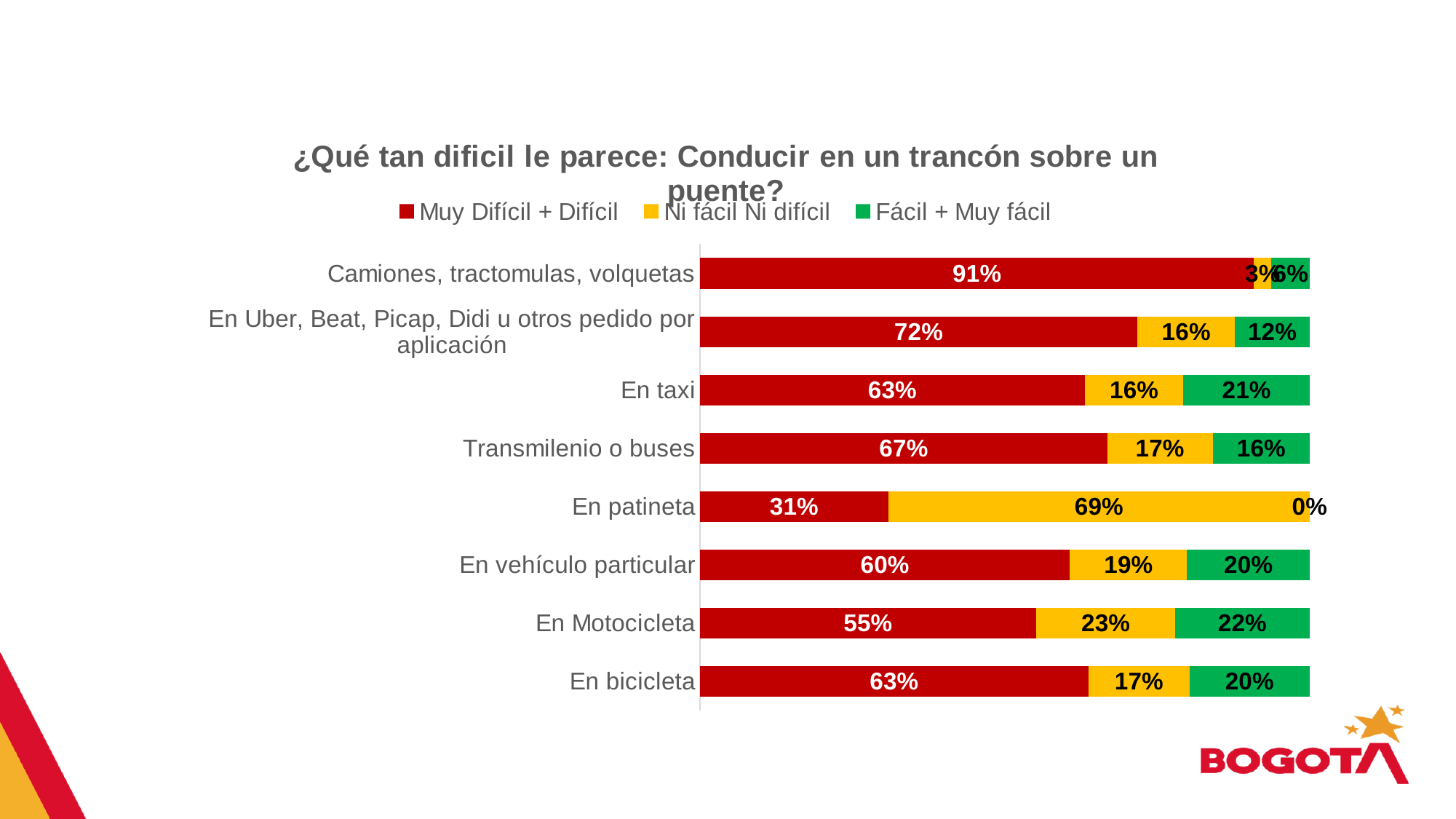
What is the difference between the 'Muy Difícil + Difícil' values for 'En Uber, Beat, Picap, Didi u otros pedido por aplicación' and 'En Motocicleta'? 17% How many categories are shown in the chart? 8 Which has a larger 'Fácil + Muy fácil' value: 'En Motocicleta' or 'Transmilenio o buses'? En Motocicleta What is the 'Ni fácil Ni difícil' value for 'En patineta'? 69% What percentage of respondents rated driving in a traffic jam on a bridge as 'Muy Difícil + Difícil' for 'Camiones, tractomulas, volquetas'? 91% Which colour represents the 'Fácil + Muy fácil' series? Green What is the total of the stacked bar for 'En bicicleta'? 100% Which category has the lowest 'Muy Difícil + Difícil' value? En patineta What kind of chart is shown on the slide? Stacked bar chart How many series does the legend list? 3 Which category has the highest 'Muy Difícil + Difícil' value? Camiones, tractomulas, volquetas What is the 'Fácil + Muy fácil' value for 'En taxi'? 21%